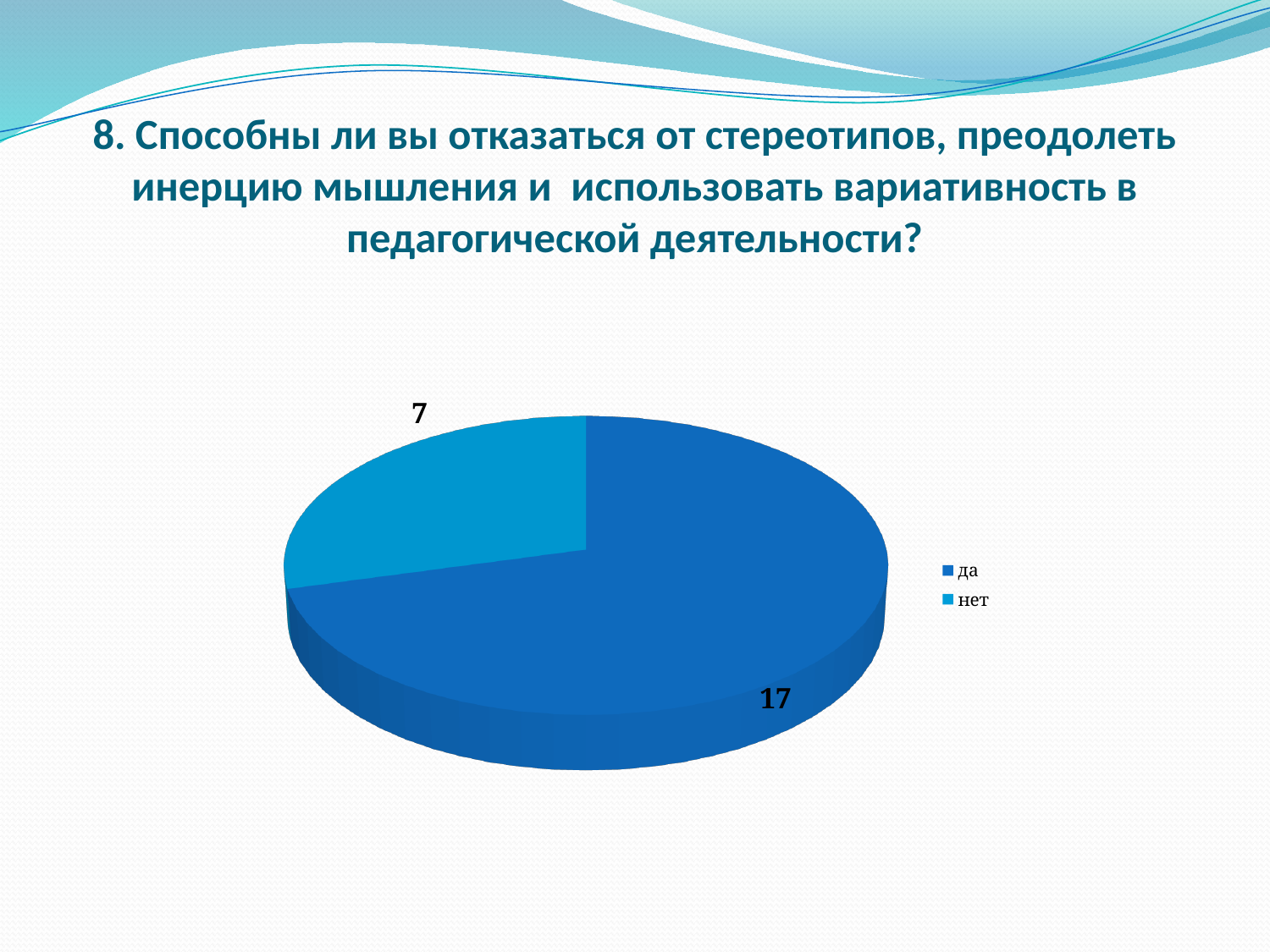
How many slices does the pie chart have? 2 What kind of chart is shown on the slide? pie chart Which category has the largest slice? да What is the value for "нет"? 7 What is the difference between the values for "да" and "нет"? 10 Which legend entry is shown in the lighter blue colour? нет Which is larger, the value for "да" or the value for "нет"? да Which category has the smallest slice? нет What is the value for "да"? 17 Where is the legend positioned relative to the pie? to the right What is the total of all slices in the pie chart? 24 How many entries does the legend list? 2